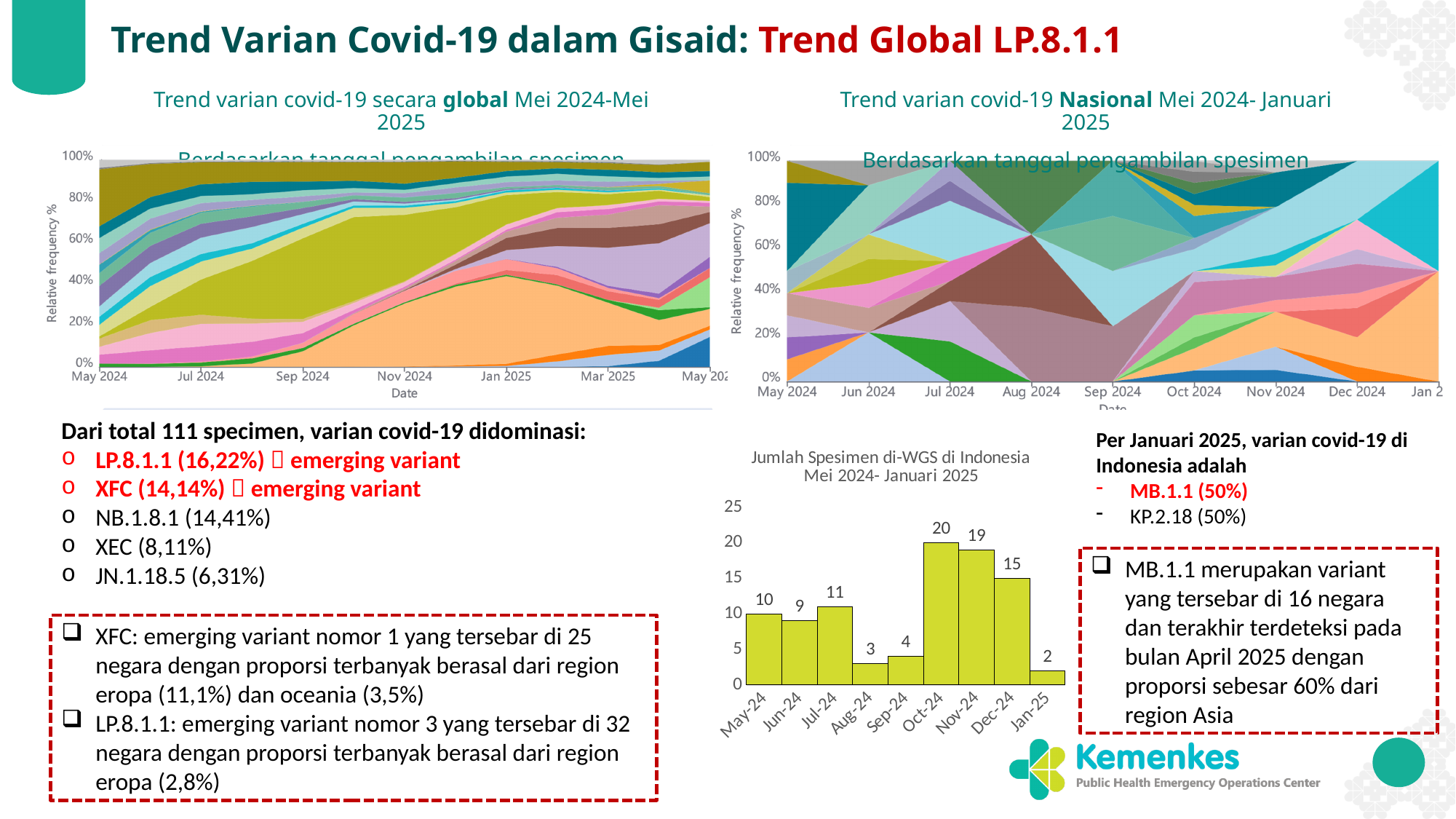
In the chart titled "Jumlah Spesimen di-WGS di Indonesia Mei 2024- Januari 2025", what is the value for Aug-24? 3 In the chart titled "Jumlah Spesimen di-WGS di Indonesia Mei 2024- Januari 2025", which is larger, the value for May-24 or the value for Jun-24? May-24 What kind of chart is the one titled "Jumlah Spesimen di-WGS di Indonesia Mei 2024- Januari 2025"? Bar chart In the chart titled "Jumlah Spesimen di-WGS di Indonesia Mei 2024- Januari 2025", which month has the highest value? Oct-24 In the chart titled "Jumlah Spesimen di-WGS di Indonesia Mei 2024- Januari 2025", do the values rise or fall from Oct-24 to Jan-25? Fall In the chart titled "Jumlah Spesimen di-WGS di Indonesia Mei 2024- Januari 2025", what is the difference between the values for Oct-24 and Nov-24? 1 In the chart titled "Jumlah Spesimen di-WGS di Indonesia Mei 2024- Januari 2025", what is the difference between the values for Jul-24 and Aug-24? 8 In the chart titled "Jumlah Spesimen di-WGS di Indonesia Mei 2024- Januari 2025", how many months are shown on the x axis? 9 In the chart titled "Jumlah Spesimen di-WGS di Indonesia Mei 2024- Januari 2025", what is the value for Dec-24? 15 In the chart titled "Jumlah Spesimen di-WGS di Indonesia Mei 2024- Januari 2025", what is the value for Oct-24? 20 In the chart titled "Jumlah Spesimen di-WGS di Indonesia Mei 2024- Januari 2025", which month has the lowest value? Jan-25 What is the label on the y axis of the top-left chart showing the global covid-19 variant trend? Relative frequency %